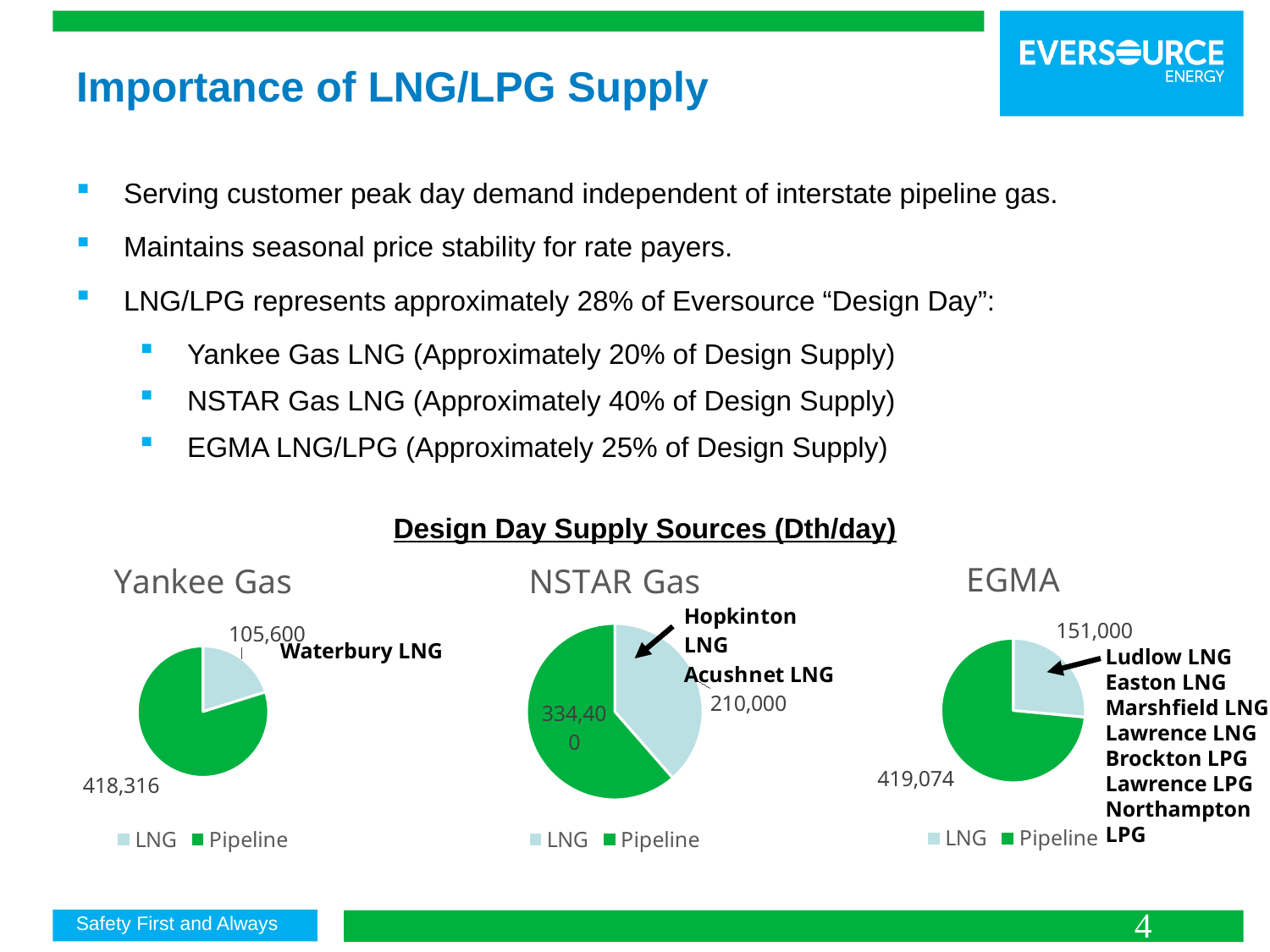
In the Yankee Gas pie chart, what is the value for Pipeline? 418,316 What type of chart is used for the Design Day Supply Sources? Pie chart In the EGMA pie chart, what is the value for LNG? 151,000 In the NSTAR Gas pie chart, which slice is larger, LNG or Pipeline? Pipeline In the Yankee Gas pie chart, what is the total of the LNG and Pipeline values? 523,916 In the Yankee Gas pie chart, what is the value for LNG? 105,600 In the EGMA pie chart, what is the difference between the Pipeline and LNG values? 268,074 In the NSTAR Gas pie chart, what is the value for LNG? 210,000 In the Yankee Gas pie chart, what is the difference between the Pipeline and LNG values? 312,716 In the EGMA pie chart, what is the value for Pipeline? 419,074 How many entries does the legend of the NSTAR Gas pie chart list? 2 What is the title above the three pie charts? Design Day Supply Sources (Dth/day)